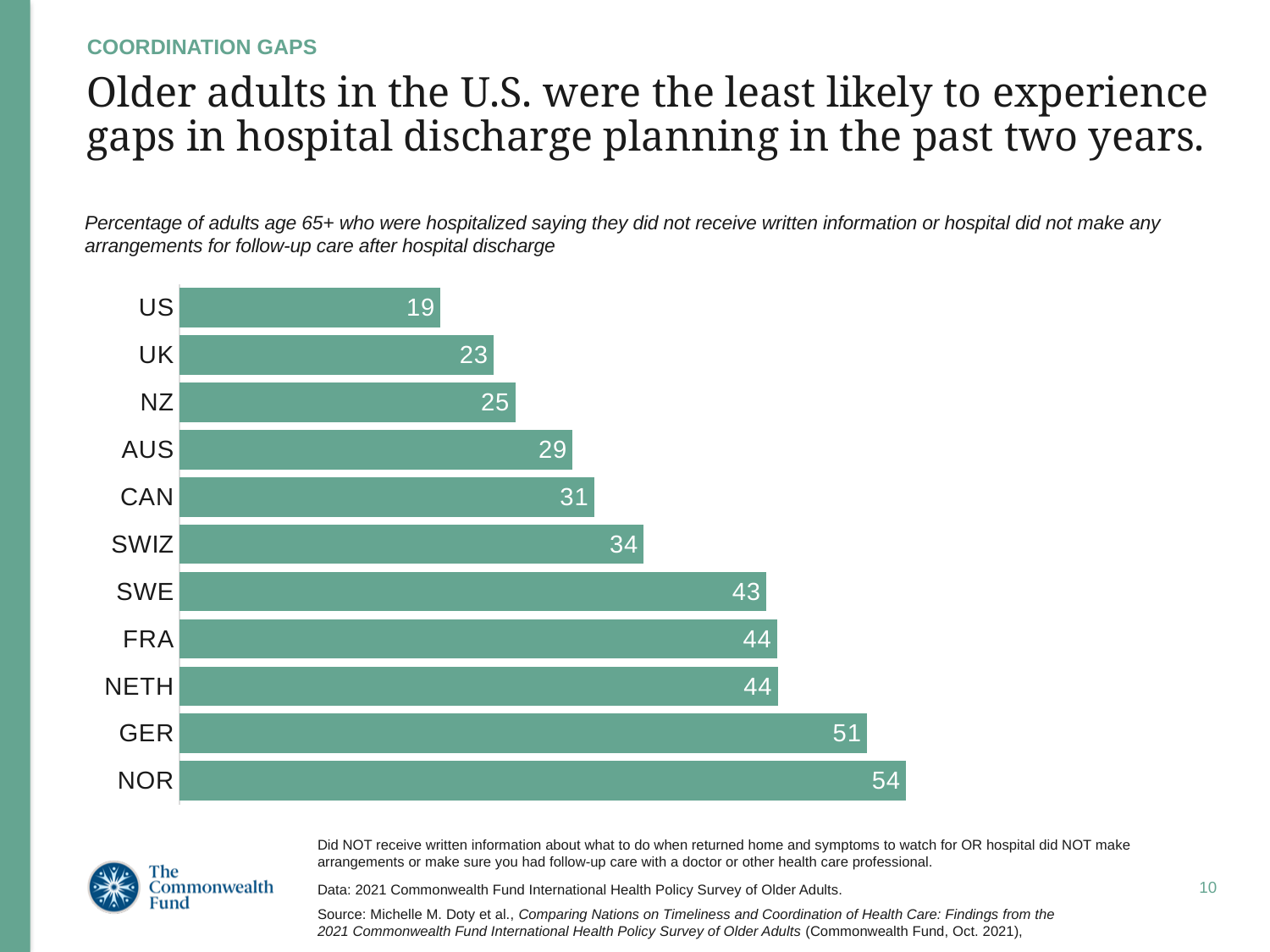
What kind of chart is shown on the slide? bar chart What is the value for NZ? 25 Which country has the lowest value? US What is the value for SWIZ? 34 What is the value for the US? 19 What is the value for GER? 51 Which is larger, the value for AUS or the value for UK? AUS How many countries are shown in the chart? 11 What is the difference between the values for SWE and CAN? 12 Which two countries share the same value of 44? FRA and NETH What is the difference between the values for NOR and US? 35 Which country has the highest value? NOR